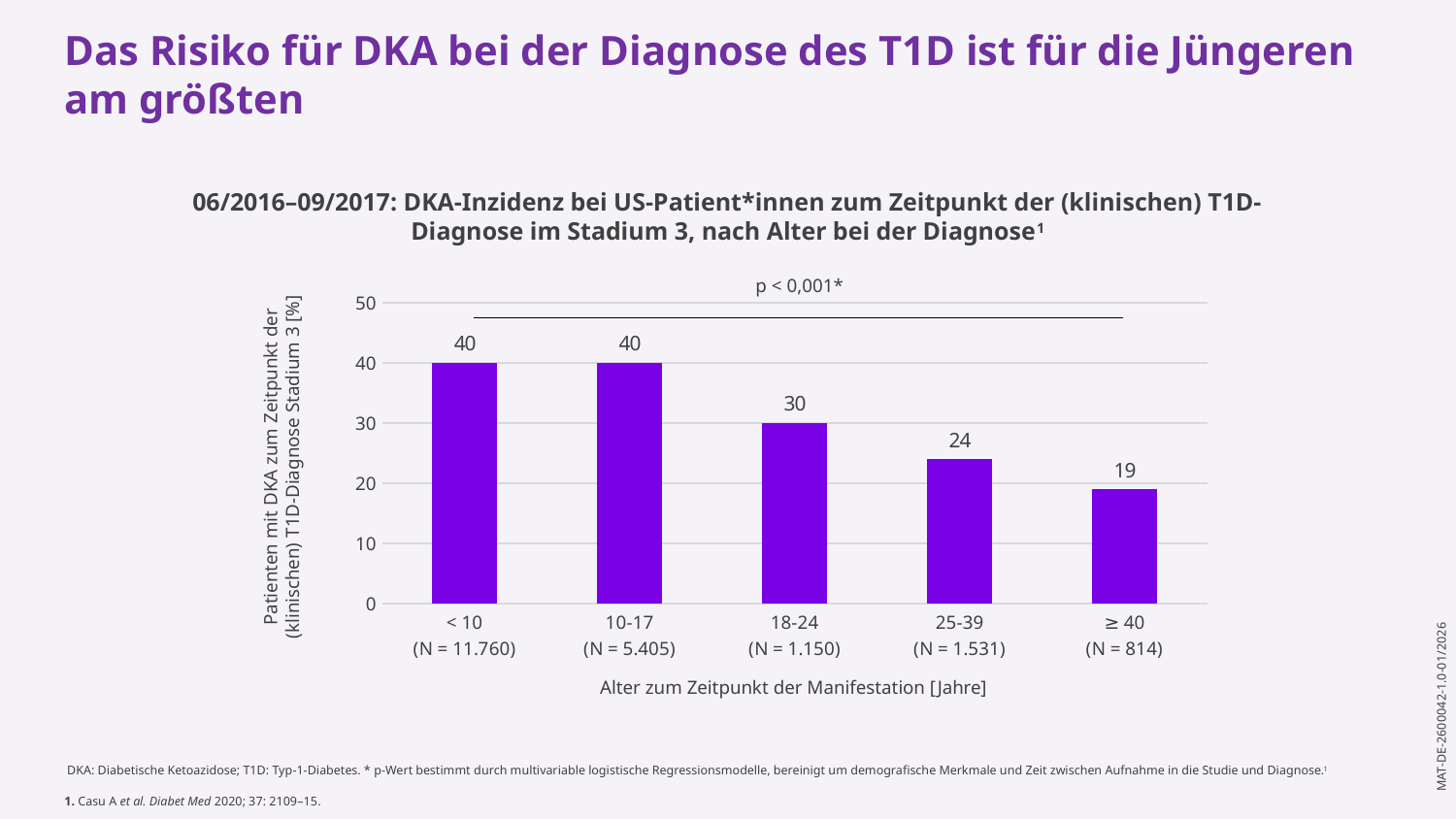
What is the difference between the values for the 10-17 and ≥ 40 age groups? 21 What is the difference between the values for the 18-24 and 25-39 age groups? 6 How many age groups are shown on the x axis? 5 Which age group has the lowest value? ≥ 40 What is the value for the ≥ 40 age group? 19 Do the values rise or fall as age increases along the x axis? Fall What is the x-axis title of the chart? Alter zum Zeitpunkt der Manifestation [Jahre] What kind of chart is shown? Bar chart What is the value for the < 10 age group? 40 Which is larger, the value for 18-24 or the value for 25-39? 18-24 What is the value for the 25-39 age group? 24 What is the value for the 18-24 age group? 30